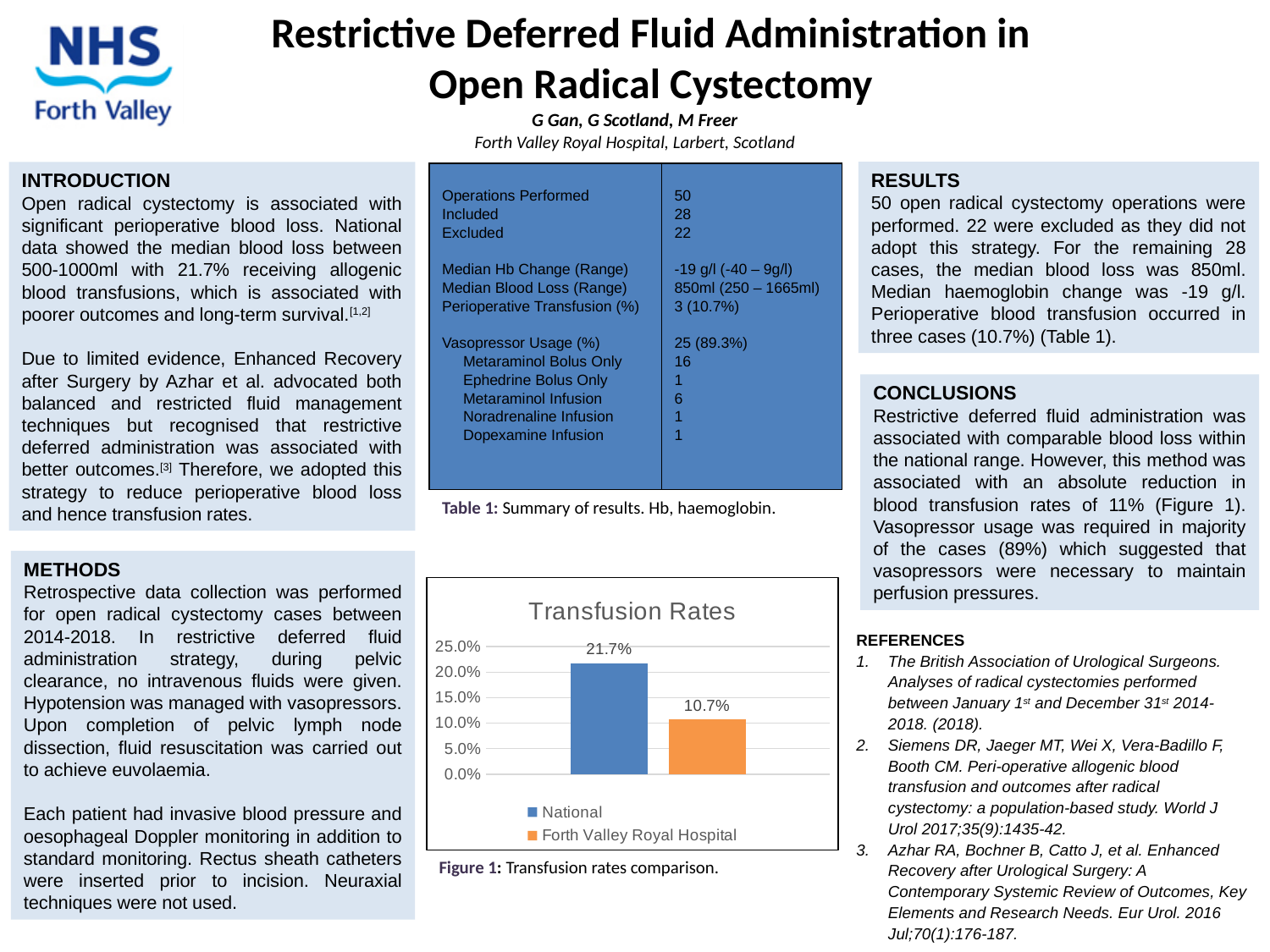
What type of chart is used to show the transfusion rates? bar chart Is the value for Forth Valley Royal Hospital greater or less than 15.0%? less What is the transfusion rate shown for National in the Transfusion Rates chart? 21.7% Which series has the higher transfusion rate in the chart? National What is the transfusion rate shown for Forth Valley Royal Hospital in the Transfusion Rates chart? 10.7% How many series does the legend of the Transfusion Rates chart list? 2 Which series has the lower transfusion rate in the chart? Forth Valley Royal Hospital Is the National transfusion rate larger or smaller than the Forth Valley Royal Hospital rate? larger Is the value for National greater or less than 20.0%? greater What is the title of the chart on the slide? Transfusion Rates How many bars are plotted in the Transfusion Rates chart? 2 What is the difference between the National and Forth Valley Royal Hospital transfusion rates? 11.0%